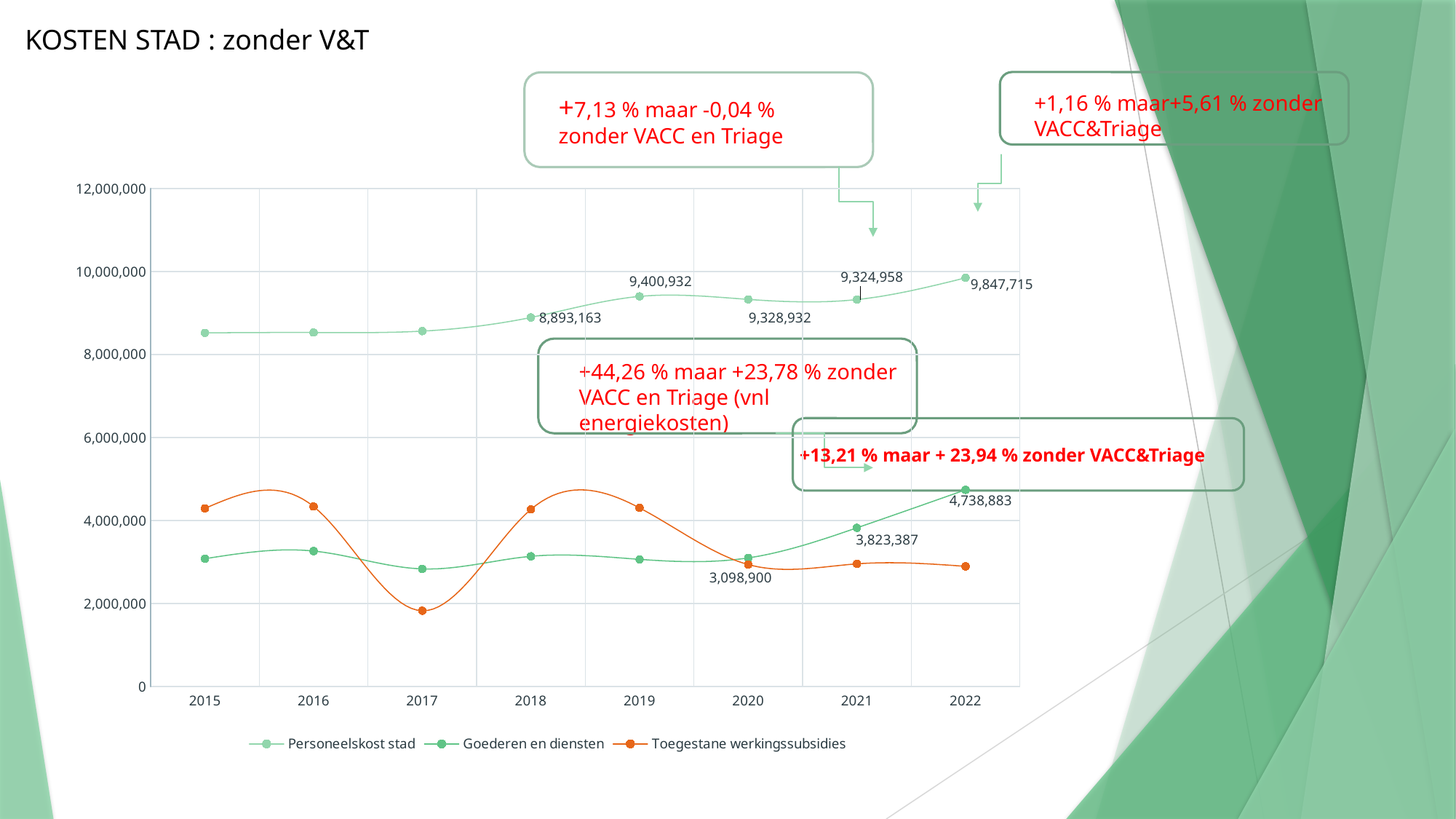
What type of chart is shown on the slide? line chart What is the value of Goederen en diensten in 2021? 3,823,387 Is the value for Toegestane werkingssubsidies in 2017 greater or less than 2,000,000? less What is the value of Goederen en diensten in 2020? 3,098,900 How many series does the legend list? 3 Which series has the highest values across all years? Personeelskost stad What is the value of Personeelskost stad in 2022? 9,847,715 What is the difference between Personeelskost stad in 2022 and in 2019? 446,783 What is the difference between Goederen en diensten in 2022 and in 2021? 915,496 What is the value of Personeelskost stad in 2018? 8,893,163 How many years are shown on the x axis? 8 Which is larger in 2019: Toegestane werkingssubsidies or Goederen en diensten? Toegestane werkingssubsidies